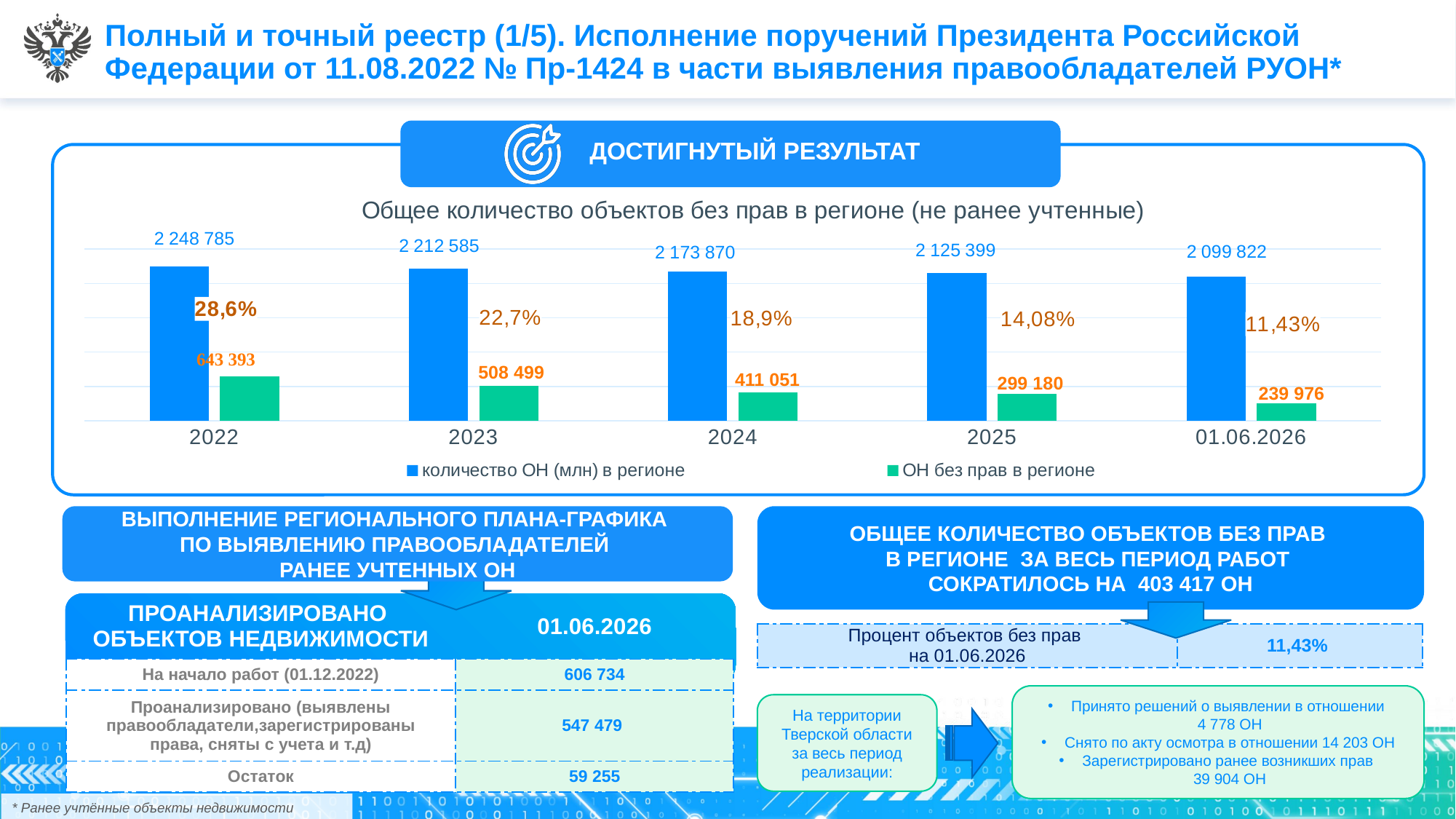
What is the value of the 'ОН без прав в регионе' series for 2024? 411 051 What is the value of the 'ОН без прав в регионе' series for 01.06.2026? 239 976 Do the values of the 'ОН без прав в регионе' series rise or fall from 2022 to 01.06.2026? fall How many categories are shown on the x axis of the chart? 5 Which is larger: the 'ОН без прав в регионе' value for 2023 or for 2025? 2023 Which category has the highest value for the 'ОН без прав в регионе' series? 2022 What is the value of the 'количество ОН (млн) в регионе' series for 2022? 2 248 785 Which category has the lowest value for the 'количество ОН (млн) в регионе' series? 01.06.2026 What percentage is shown above the green bar for 2025? 14,08% How many series does the chart legend list? 2 What is the difference between the 'ОН без прав в регионе' values for 2023 and 2024? 97 448 What is the difference between the 'ОН без прав в регионе' values for 2022 and 01.06.2026? 403 417